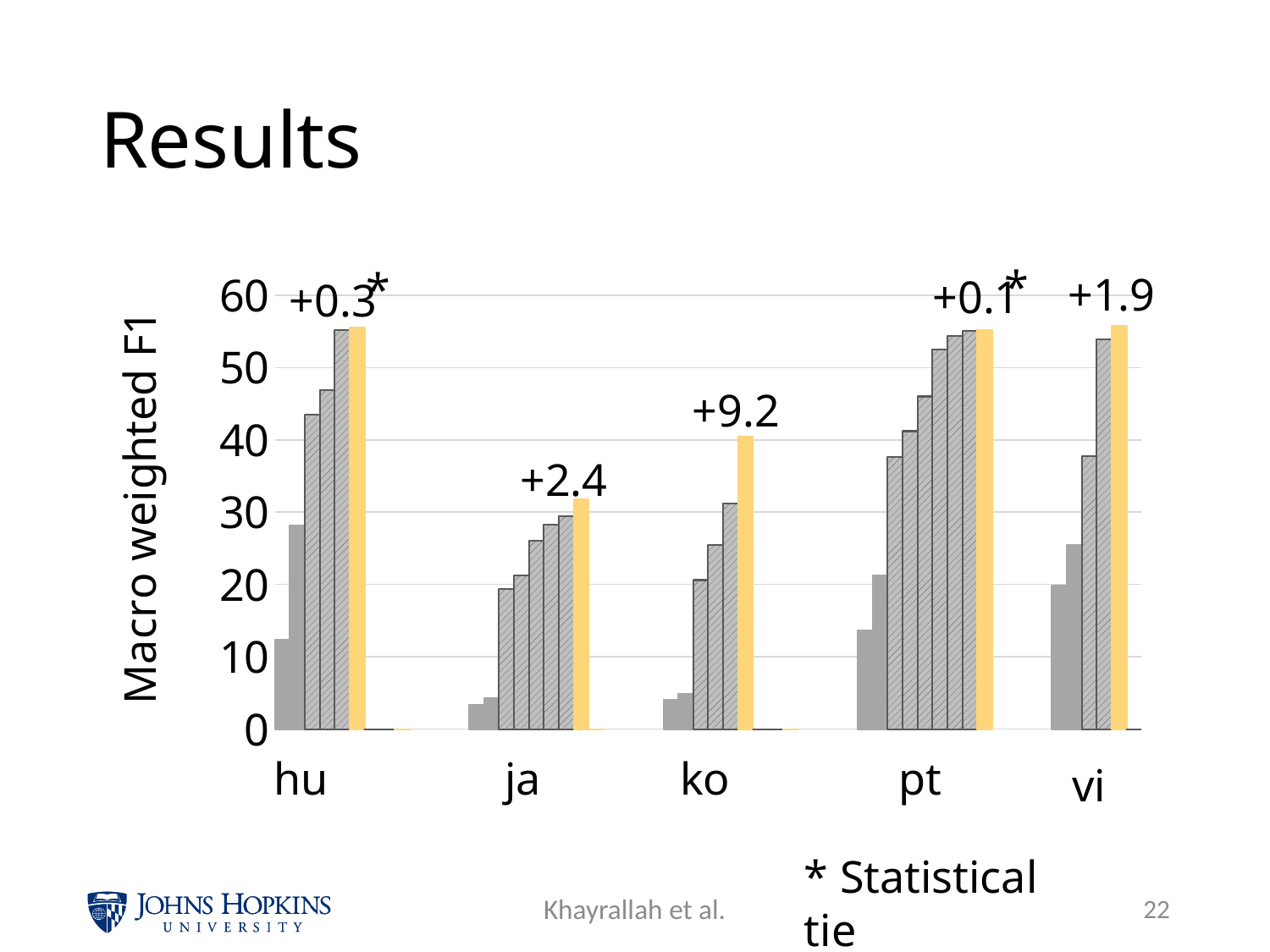
Which language has the lowest yellow bar? ja Which language has the largest annotated improvement? ko What improvement is annotated above the ja bars? +2.4 How many language categories are shown on the x axis? 5 What is the label of the y axis? Macro weighted F1 Is the value of the yellow bar for vi greater or less than 50? greater What improvement is annotated above the vi bars? +1.9 What is the difference between the annotated improvements for ko and ja? 6.8 Is the value of the yellow bar for ja greater or less than 30? greater What improvement is annotated above the ko bars? +9.2 What kind of chart is shown on the slide? bar chart Which language has the smallest annotated improvement? pt